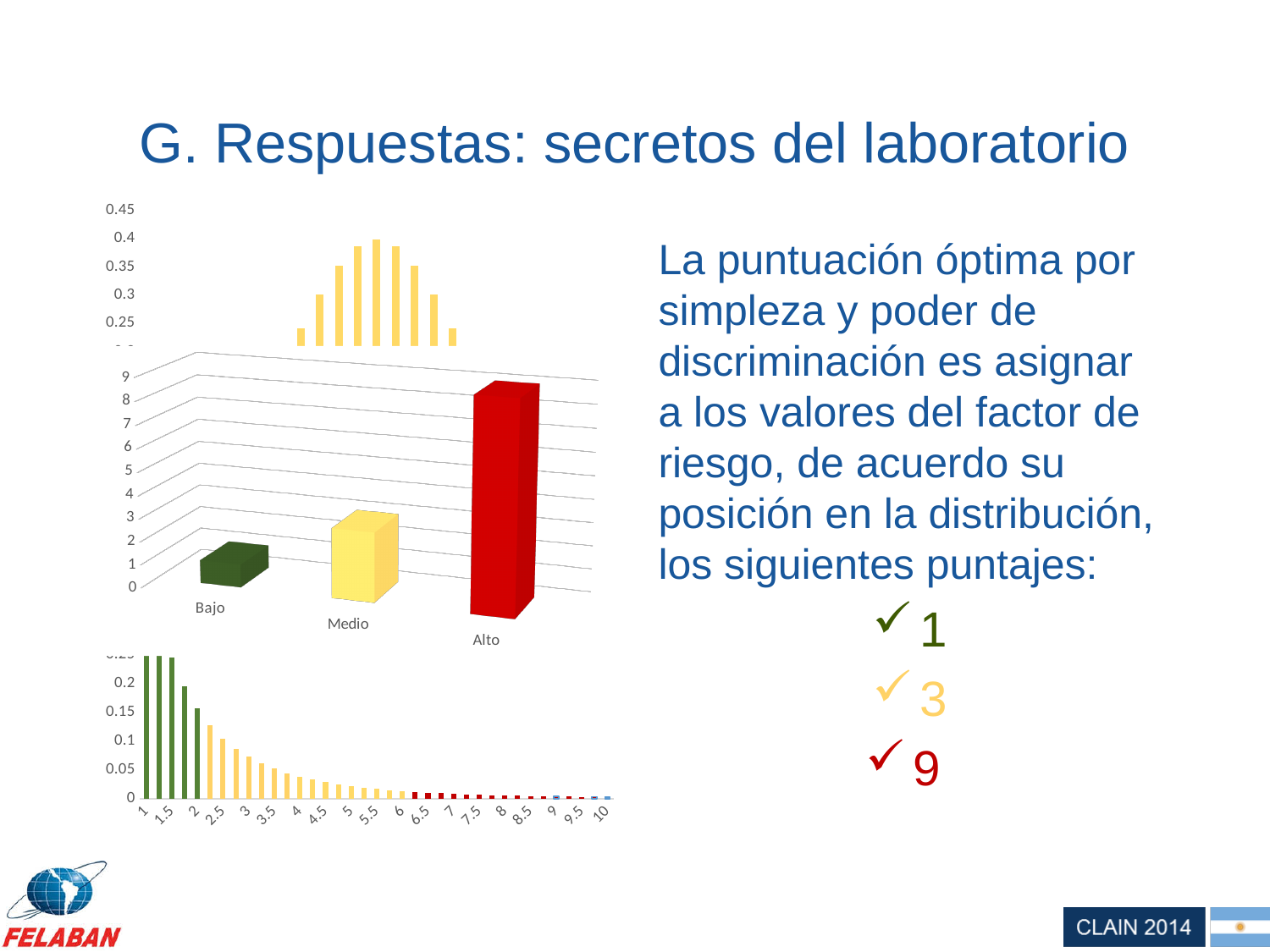
In the middle 3D chart, which is larger, the value for Medio or the value for Bajo? Medio How many categories are shown on the x axis of the middle 3D chart? 3 In the bottom chart, is the value at x = 1 greater or less than 0.2? greater In the bottom chart, do the values rise or fall as you move from 1 to 10 along the x axis? fall In the middle 3D chart, which category has the highest value? Alto In the middle 3D chart, which category has the lowest value? Bajo What kind of chart is the middle chart with the Bajo, Medio and Alto categories? bar chart In the middle 3D chart, what colour is the bar for Alto? red What kind of chart is the bottom chart on the slide? bar chart In the middle 3D chart, is the value for Alto greater or less than 5? greater In the middle 3D chart, is the value for Bajo greater or less than 2? less